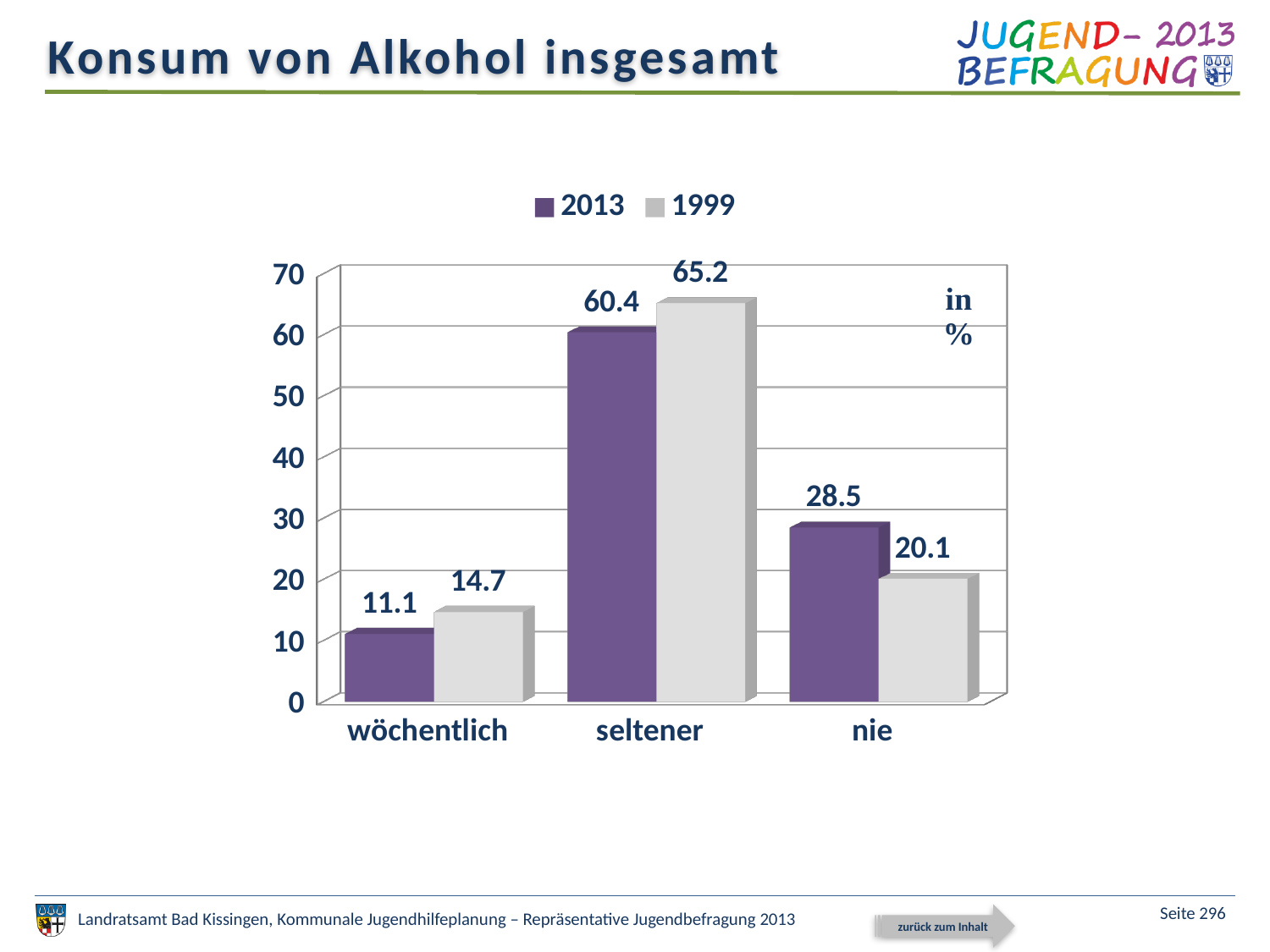
Which category has the lowest value for the 1999 series? wöchentlich In the 'wöchentlich' category, which series has the larger value, 2013 or 1999? 1999 Is the 2013 value for 'nie' greater or less than 20? greater What is the value for 1999 in the 'nie' category? 20.1 What is the value for 1999 in the 'wöchentlich' category? 14.7 What is the difference between the 1999 and 2013 values in the 'seltener' category? 4.8 How many series does the legend list? 2 What kind of chart is shown on the slide? bar chart What is the value for 2013 in the 'seltener' category? 60.4 How many categories are shown on the x axis? 3 Which category has the highest value for the 2013 series? seltener What is the difference between the 2013 and 1999 values in the 'nie' category? 8.4